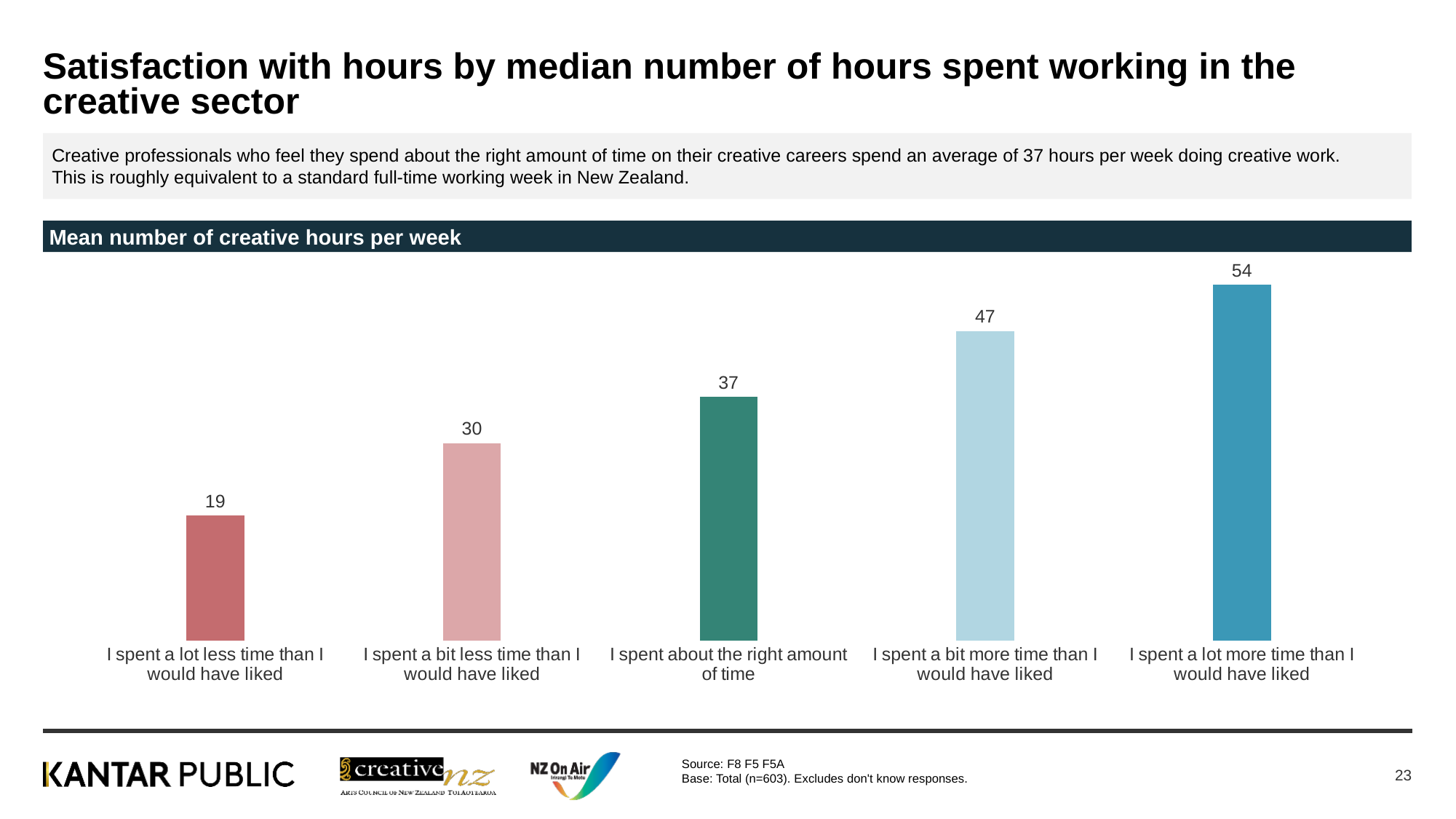
Do the values rise or fall moving from left to right across the categories? Rise How many categories are shown in the chart? 5 What is the mean number of creative hours per week for 'I spent a lot less time than I would have liked'? 19 What is the mean number of creative hours per week for 'I spent about the right amount of time'? 37 What is the mean number of creative hours per week for 'I spent a bit more time than I would have liked'? 47 What is the difference in mean creative hours per week between 'I spent a bit more time than I would have liked' and 'I spent about the right amount of time'? 10 What is the title of the chart? Mean number of creative hours per week What kind of chart is shown on the slide? Bar chart What is the difference in mean creative hours per week between 'I spent a lot more time than I would have liked' and 'I spent a lot less time than I would have liked'? 35 Which category has the highest mean number of creative hours per week? I spent a lot more time than I would have liked Which has a higher mean number of creative hours per week: 'I spent a bit less time than I would have liked' or 'I spent about the right amount of time'? I spent about the right amount of time Which category has the lowest mean number of creative hours per week? I spent a lot less time than I would have liked